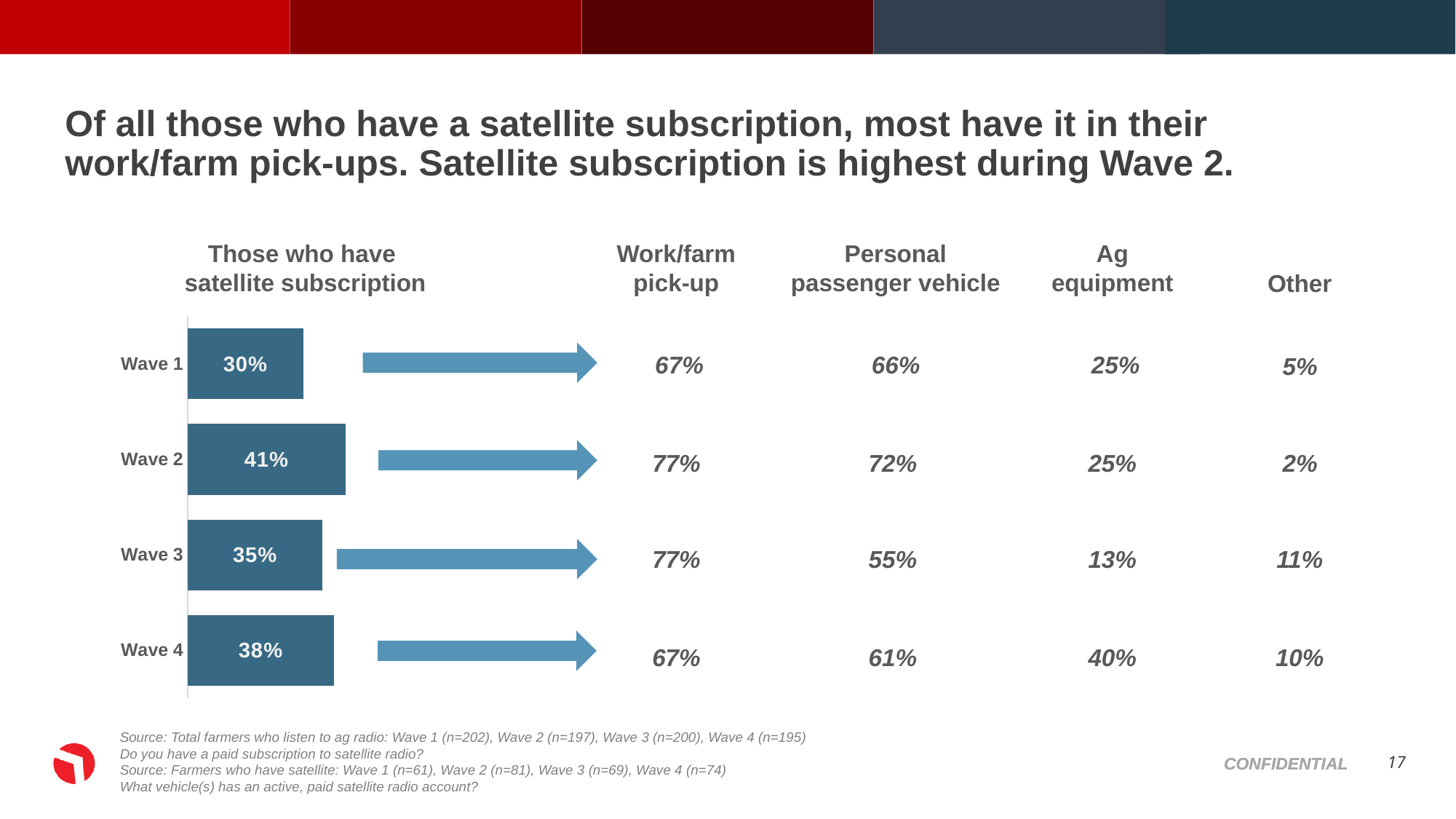
What percentage of Wave 2 respondents have a satellite subscription? 41% How many waves are shown in the satellite subscription bar chart? 4 In Wave 4, what percentage of those with satellite have it in ag equipment? 40% Which wave has the lowest share of those who have a satellite subscription? Wave 1 What kind of chart shows the share of those who have a satellite subscription? Bar chart What is the title of the bar chart on the left? Those who have satellite subscription What percentage of Wave 1 respondents have a satellite subscription? 30% What is the difference between the satellite subscription share in Wave 2 and Wave 1? 11 percentage points What is the difference between the Wave 4 satellite subscription share and the Wave 3 share? 3 percentage points Which wave has the highest share of those who have a satellite subscription? Wave 2 Which is larger, the satellite subscription share in Wave 3 or Wave 4? Wave 4 In Wave 3, what percentage of those with satellite have it in a work/farm pick-up? 77%